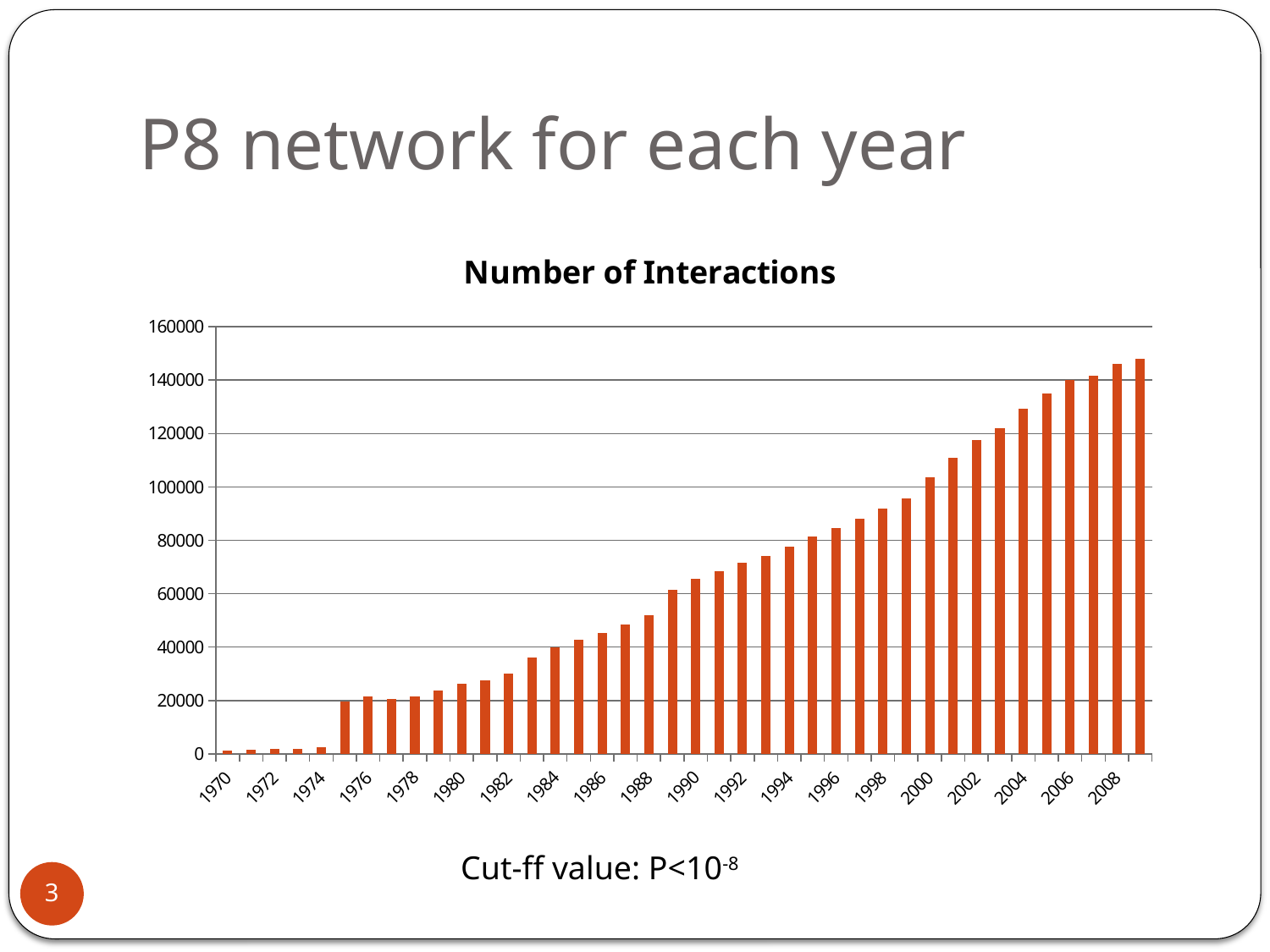
Is the value for 2004 greater or less than 120000? greater Do the values generally rise or fall from 1970 to 2009? rise Is the value for 1980 greater or less than 40000? less Which year has the highest number of interactions? 2009 Which year has the larger number of interactions, 1990 or 2000? 2000 What kind of chart is shown on the slide? bar chart Is the value for 2000 greater or less than 100000? greater What is the highest value shown on the y axis? 160000 What is the title of the chart? Number of Interactions How many bars are plotted in the chart? 40